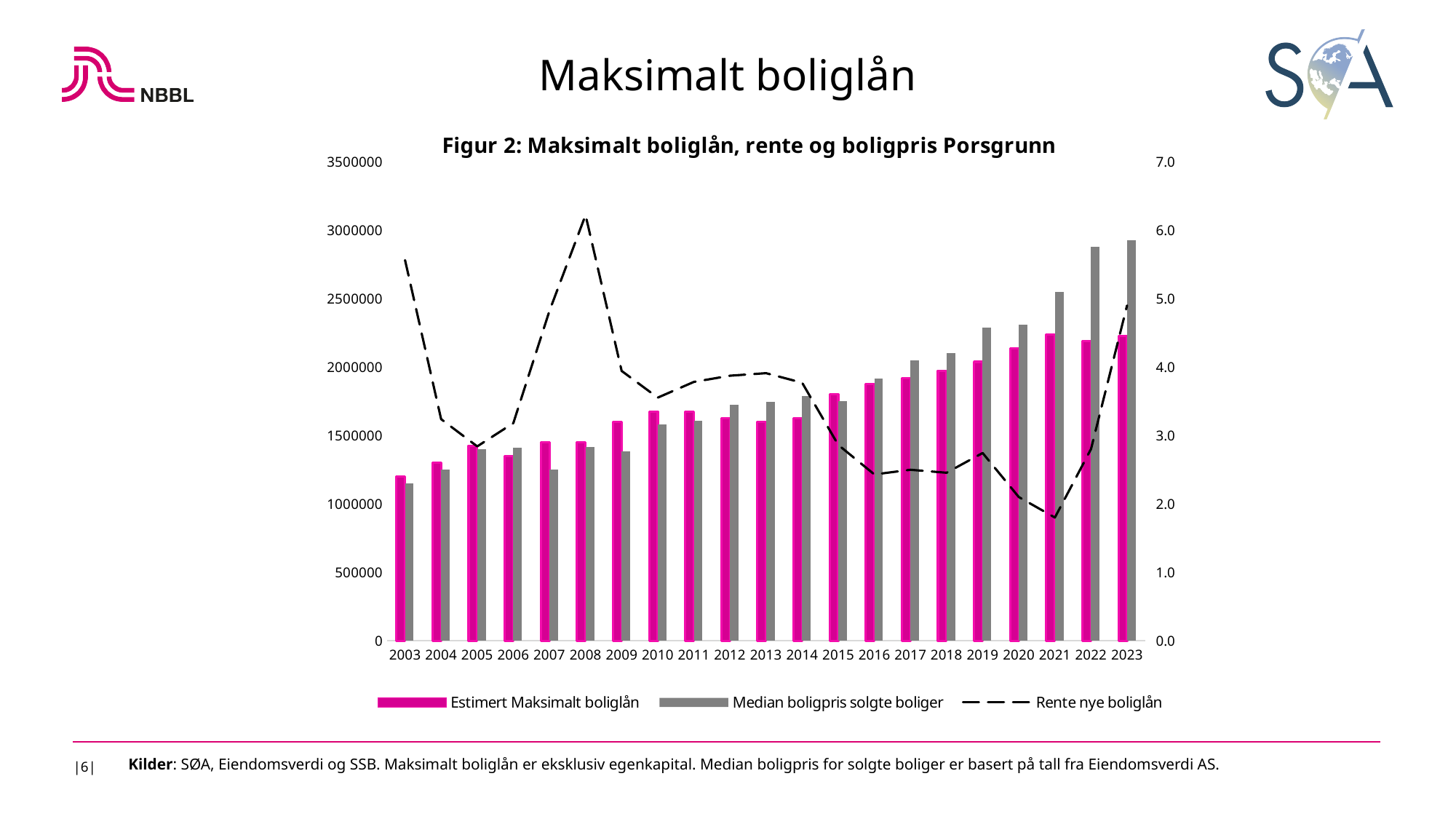
In which year is Median boligpris solgte boliger lowest? 2003 Is the value for Rente nye boliglån in 2003 greater or less than 5.0? greater How many years are shown on the x axis? 21 Is the value for Median boligpris solgte boliger in 2023 greater or less than 2500000? greater What kind of chart is used to show Estimert Maksimalt boliglån and Median boligpris solgte boliger? bar chart In which year is Estimert Maksimalt boliglån lowest? 2003 In which year is Median boligpris solgte boliger highest? 2023 In 2022, which is larger: Estimert Maksimalt boliglån or Median boligpris solgte boliger? Median boligpris solgte boliger Does Median boligpris solgte boliger rise or fall from 2014 to 2023? rise What is the title of the chart? Figur 2: Maksimalt boliglån, rente og boligpris Porsgrunn How many series does the legend list? 3 What kind of chart is used to show Rente nye boliglån? line chart